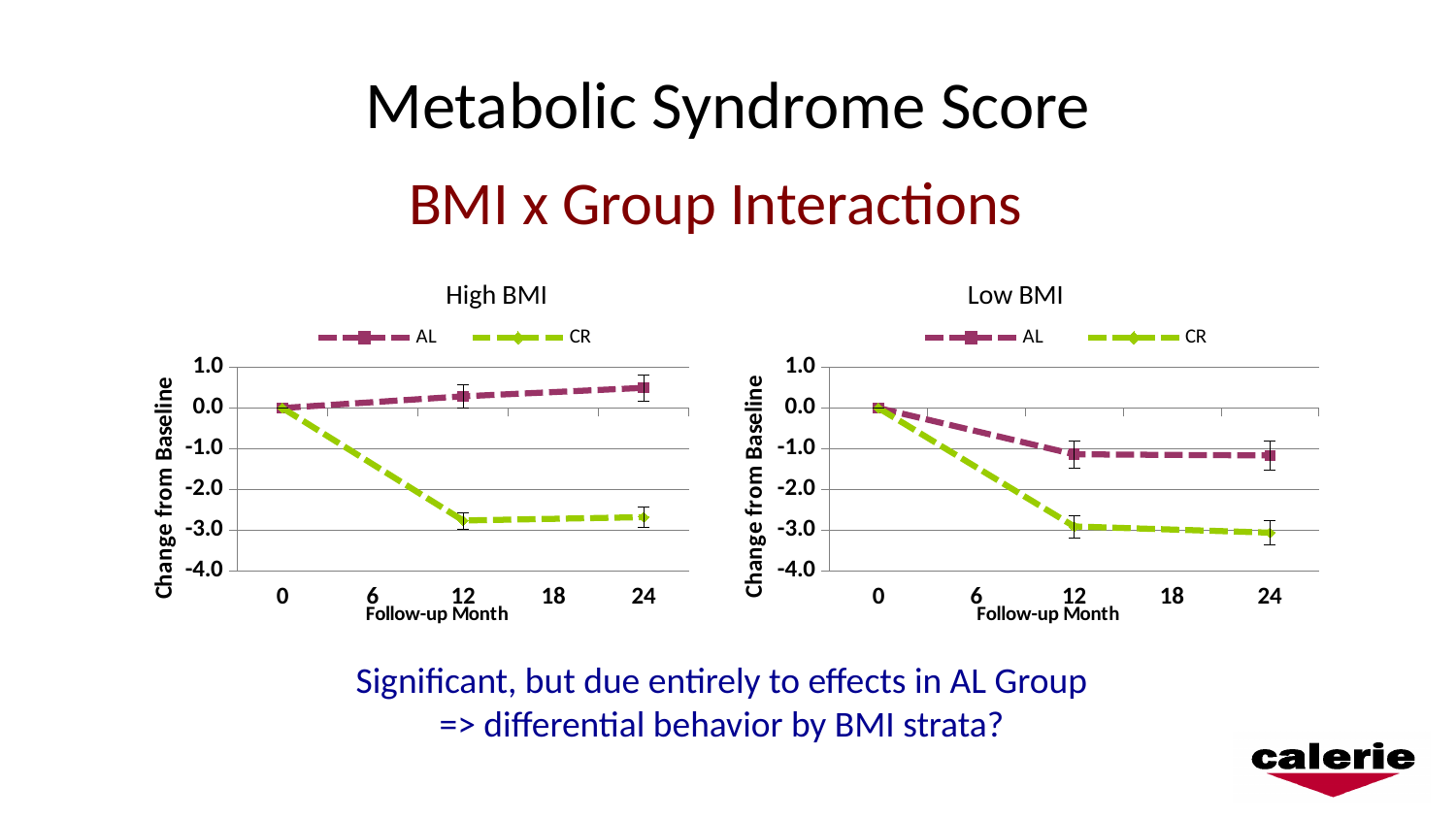
In the High BMI chart, what is the value for CR at follow-up month 0? 0.0 In the Low BMI chart, which series has the lowest value at follow-up month 24? CR What kind of chart is the High BMI chart? line chart In the High BMI chart, does the CR series rise or fall from month 0 to month 12? fall In the Low BMI chart, is the value for AL at follow-up month 12 greater or less than -2.0? greater In the Low BMI chart, does the AL series rise or fall from month 0 to month 12? fall In the High BMI chart, is the value for AL at follow-up month 24 greater or less than 0.0? greater How many series does the legend of the Low BMI chart list? 2 In the Low BMI chart, is the value for CR at follow-up month 24 greater or less than -2.0? less What is the y-axis title of the Low BMI chart? Change from Baseline In the High BMI chart, which series has the larger value at follow-up month 24, AL or CR? AL